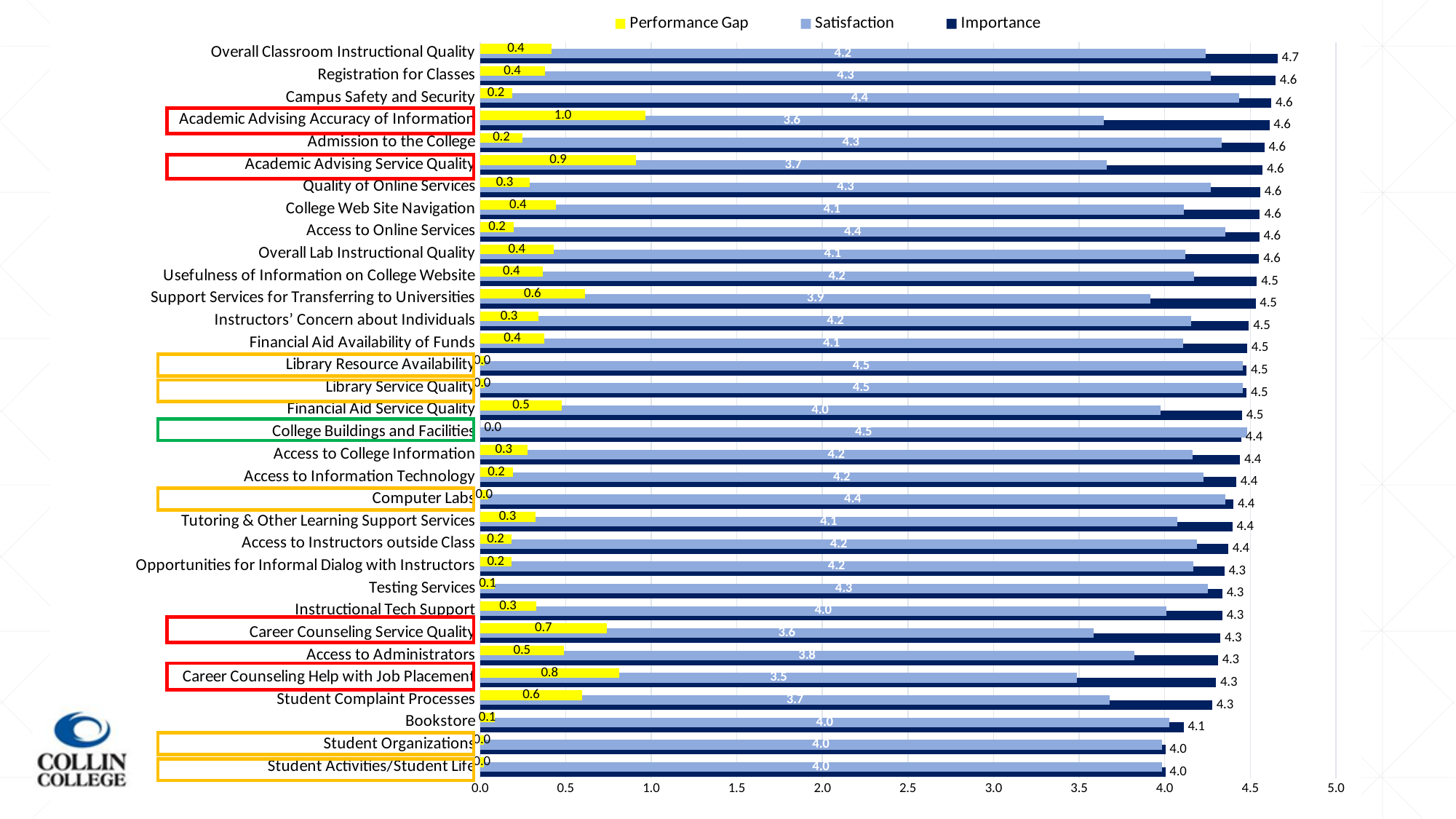
Is the Satisfaction value for Access to Administrators greater or less than 4.0? less What is the Importance value for Overall Classroom Instructional Quality? 4.7 Which category has the highest Performance Gap? Academic Advising Accuracy of Information Which category has the lowest Satisfaction value? Career Counseling Help with Job Placement Which series is shown in yellow in the legend? Performance Gap Which is larger, the Satisfaction value for Campus Safety and Security or the Satisfaction value for Student Complaint Processes? Campus Safety and Security What kind of chart is shown on the slide? Bar chart What is the difference between the Importance and Satisfaction values for Academic Advising Service Quality? 0.9 Which category has the highest Importance value? Overall Classroom Instructional Quality What is the Performance Gap value for Academic Advising Accuracy of Information? 1.0 How many series does the legend list? 3 What is the Satisfaction value for Career Counseling Help with Job Placement? 3.5